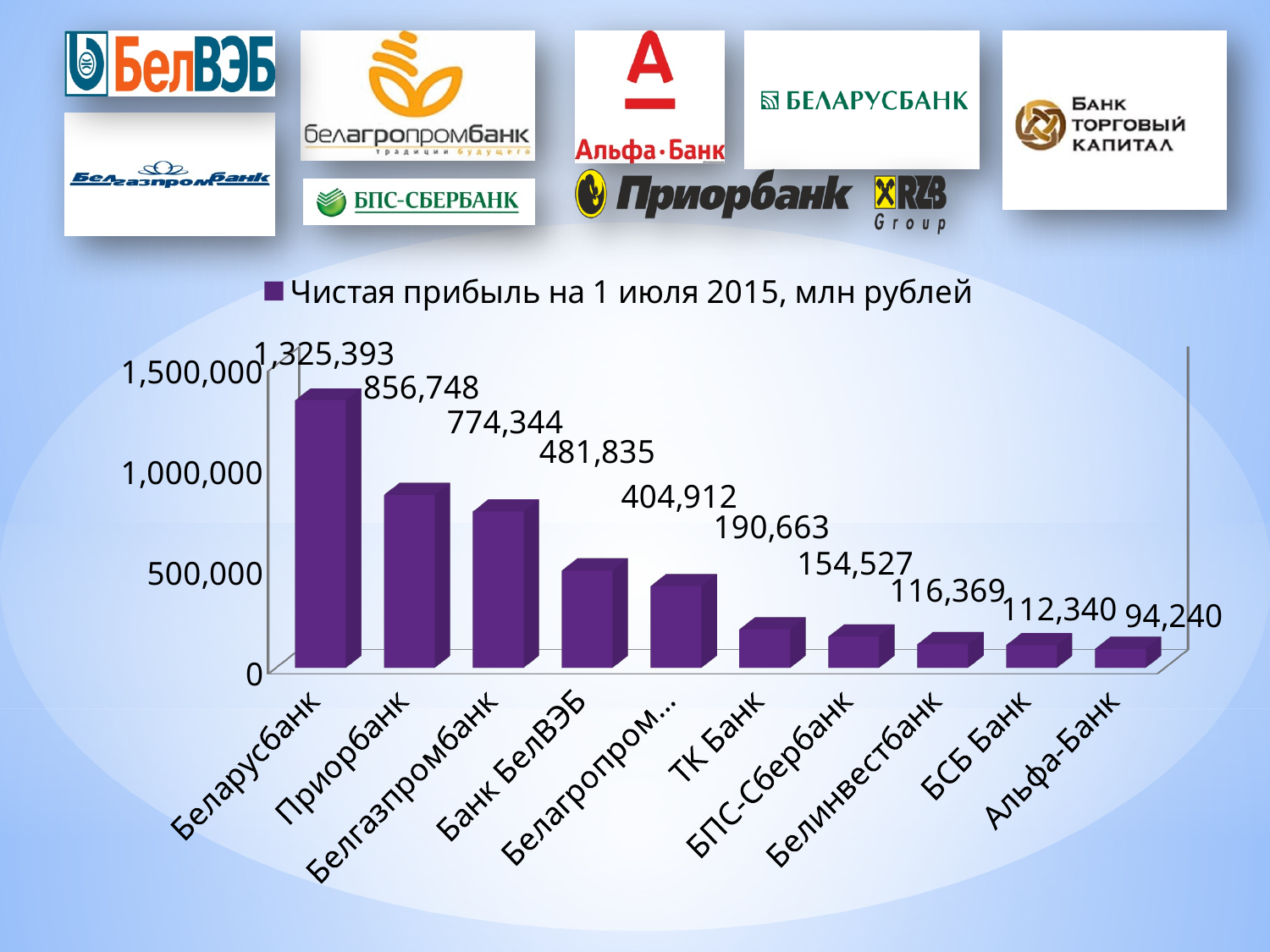
What value is labelled for Приорбанк? 856,748 What does the legend entry of the chart say? Чистая прибыль на 1 июля 2015, млн рублей What kind of chart is shown on the slide? Bar chart What is the value shown for БПС-Сбербанк? 154,527 What is the difference between the values for БСБ Банк and Альфа-Банк? 18,100 Which bank has the lowest value in the chart? Альфа-Банк Which is larger, the value for Банк БелВЭБ or the value for ТК Банк? Банк БелВЭБ What value is shown for Альфа-Банк? 94,240 What is the difference between the values for Приорбанк and Белгазпромбанк? 82,404 What is the net profit value shown for Беларусбанк? 1,325,393 Which bank has the highest bar in the chart? Беларусбанк How many banks are shown as categories in the chart? 10